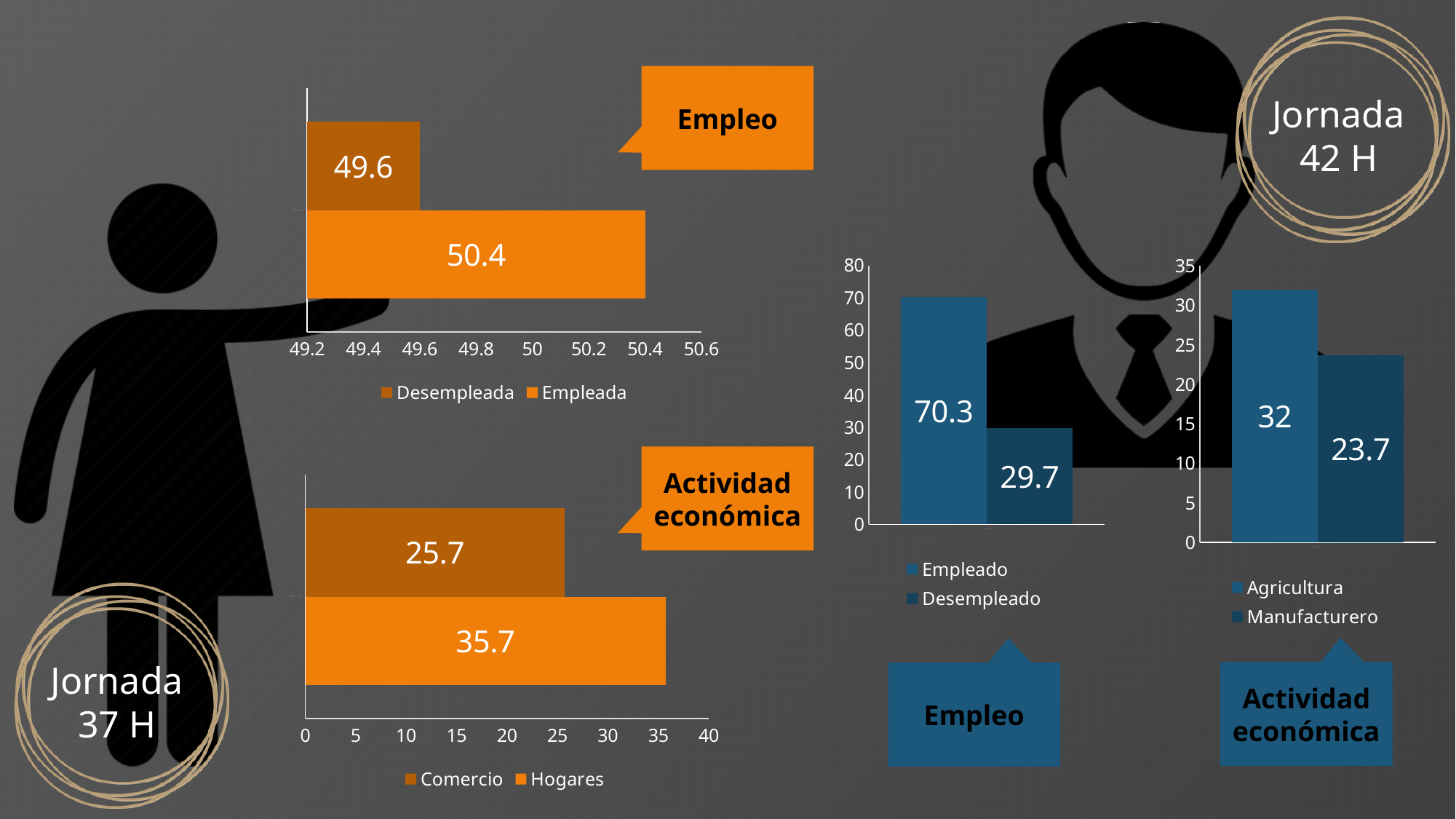
In the orange Empleo bar chart on the left side of the slide, what is the value for Desempleada? 49.6 In the orange Actividad económica bar chart on the left, what is the value for Hogares? 35.7 In the orange Actividad económica bar chart on the left, what is the difference between Hogares and Comercio? 10 In the orange Actividad económica bar chart on the left, which series has the lower value, Comercio or Hogares? Comercio In the orange Empleo bar chart on the left side of the slide, what is the value for Empleada? 50.4 What type of chart is the orange Actividad económica chart on the left side of the slide? Bar chart In the blue Empleo bar chart on the right side of the slide, what is the value for Empleado? 70.3 In the blue Actividad económica bar chart on the right, what is the value for Manufacturero? 23.7 In the orange Empleo bar chart on the left, what is the difference between the Empleada and Desempleada values? 0.8 In the blue Empleo bar chart on the right, what is the difference between Empleado and Desempleado? 40.6 How many series does the legend of the blue Empleo bar chart on the right list? 2 In the blue Actividad económica bar chart on the right, which series is higher, Agricultura or Manufacturero? Agricultura